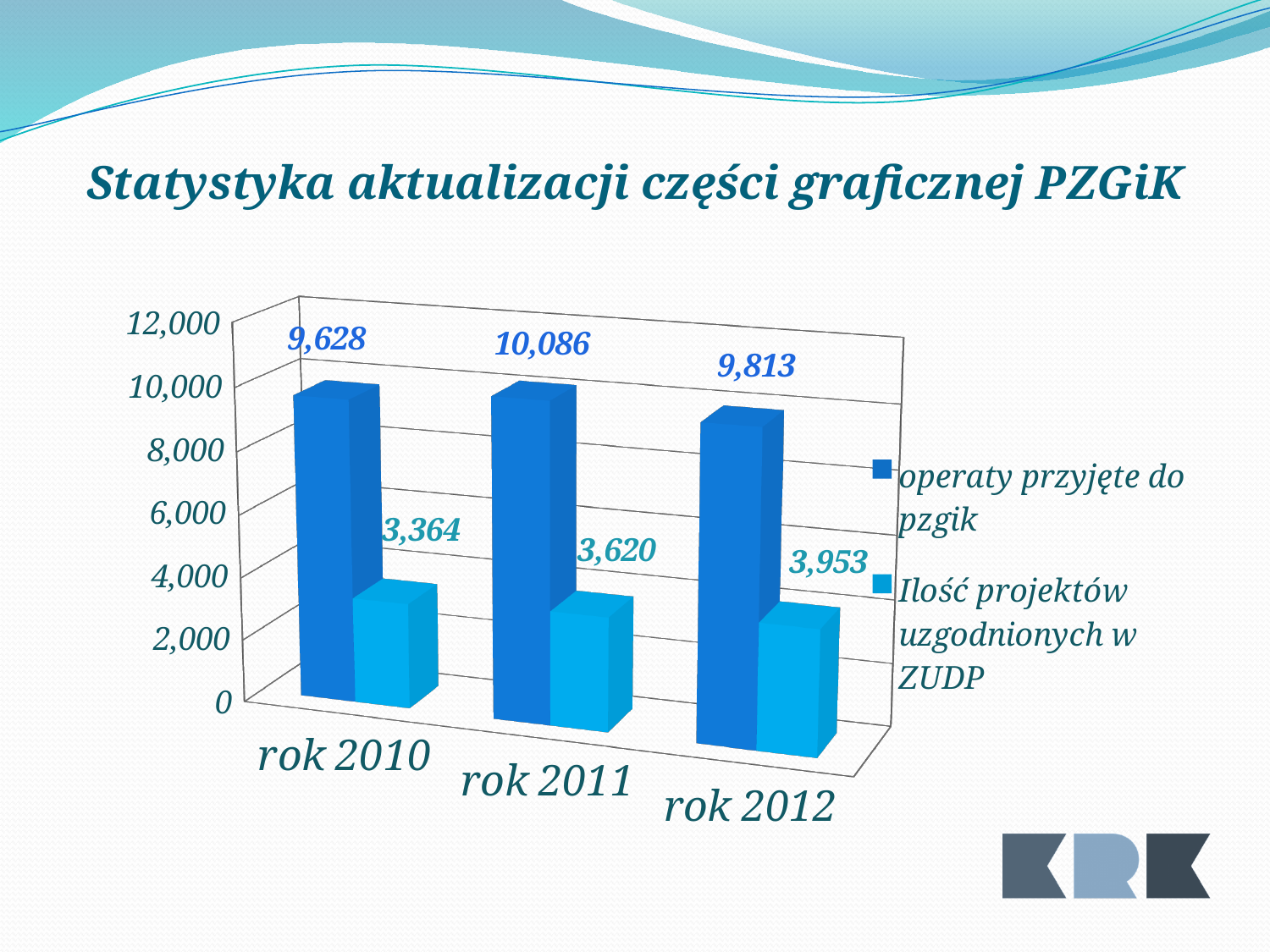
What is the value of 'Ilość projektów uzgodnionych w ZUDP' for rok 2012? 3,953 Does the value of 'Ilość projektów uzgodnionych w ZUDP' rise or fall from rok 2010 to rok 2012? rise What kind of chart is shown on the slide? bar chart What is the value of 'Ilość projektów uzgodnionych w ZUDP' for rok 2010? 3,364 What is the difference between 'Ilość projektów uzgodnionych w ZUDP' in rok 2012 and rok 2011? 333 How many series does the legend list? 2 Which is larger: 'operaty przyjęte do pzgik' in rok 2010 or in rok 2012? rok 2012 How many years are shown on the x axis? 3 Which year has the lowest value for 'Ilość projektów uzgodnionych w ZUDP'? rok 2010 What is the value of 'operaty przyjęte do pzgik' for rok 2011? 10,086 What is the difference between 'operaty przyjęte do pzgik' in rok 2011 and rok 2010? 458 Which year has the highest value for 'operaty przyjęte do pzgik'? rok 2011